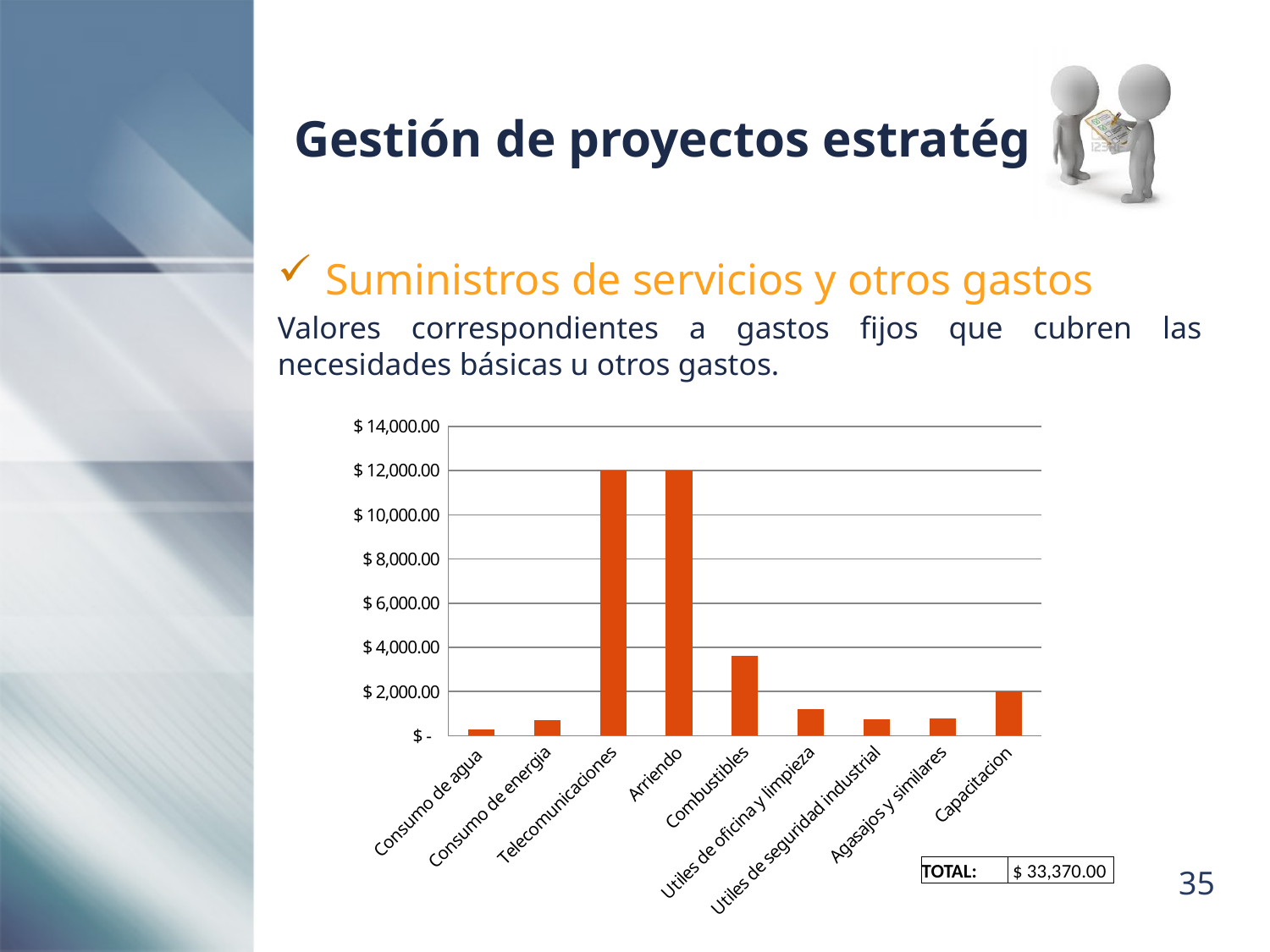
How many categories are plotted on the x axis of the chart? 9 What is the value for Arriendo? $ 12,000.00 Is the value for Consumo de energia greater or less than $ 2,000.00? less What is the difference between the values for Telecomunicaciones and Capacitacion? $ 10,000.00 What TOTAL value is shown in the box below the chart? $ 33,370.00 Is the value for Combustibles greater or less than $ 4,000.00? less Which is larger, the value for Combustibles or the value for Utiles de oficina y limpieza? Combustibles Is the value for Combustibles greater or less than $ 2,000.00? greater What is the value for Capacitacion? $ 2,000.00 What is the value for Telecomunicaciones? $ 12,000.00 Which category has the lowest value? Consumo de agua What type of chart is shown on the slide? bar chart